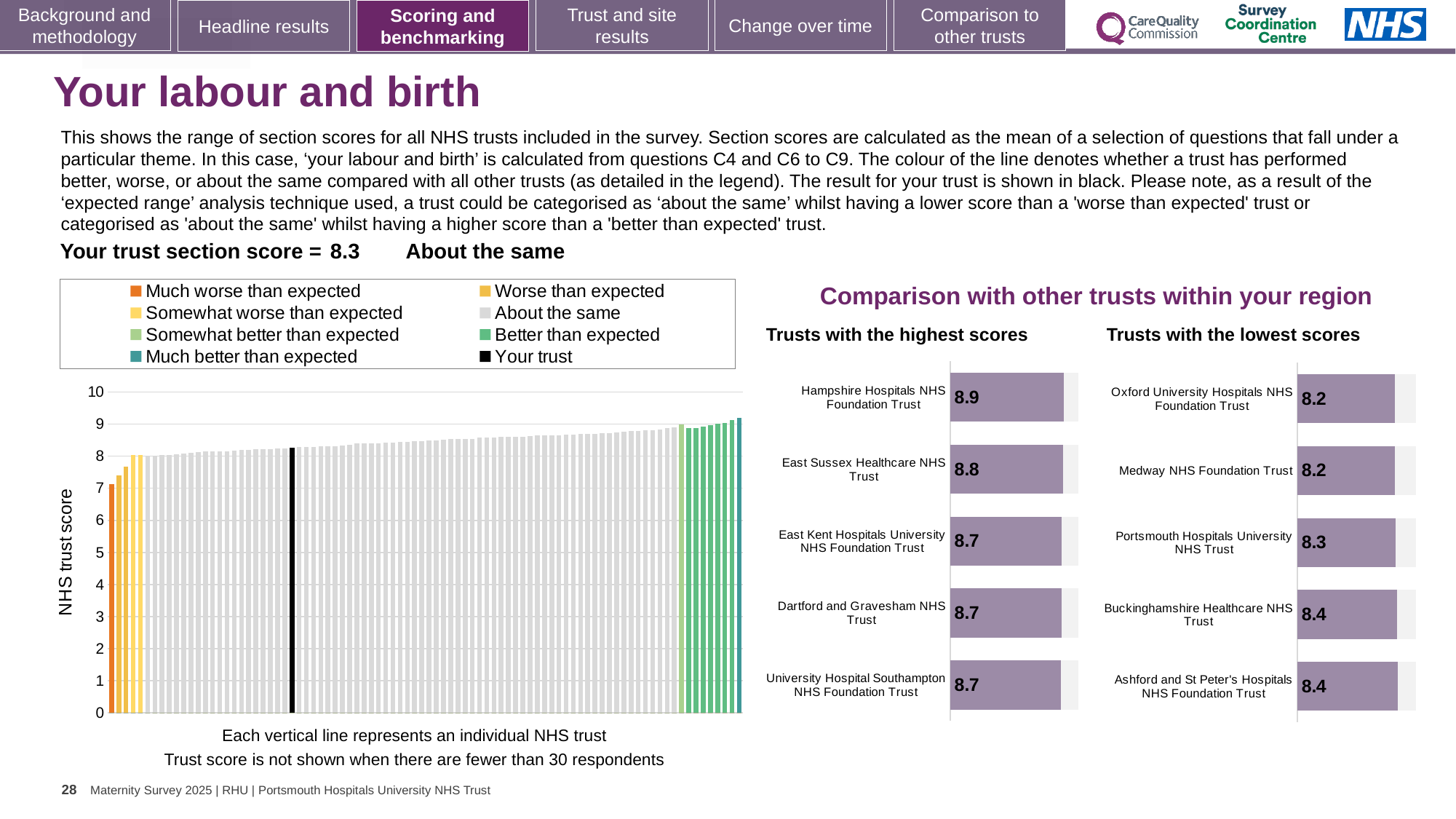
What kind of chart is the large chart on the left showing all NHS trusts? Bar chart In the large chart on the left, do the trust scores rise or fall from left to right along the x axis? Rise In the 'Trusts with the highest scores' chart, which trust has the highest score? Hampshire Hospitals NHS Foundation Trust In the 'Trusts with the lowest scores' chart, which is larger: the score for Buckinghamshire Healthcare NHS Trust or Oxford University Hospitals NHS Foundation Trust? Buckinghamshire Healthcare NHS Trust In the 'Trusts with the lowest scores' chart, what is the difference between the scores of Ashford and St Peter's Hospitals NHS Foundation Trust and Oxford University Hospitals NHS Foundation Trust? 0.2 In the 'Trusts with the lowest scores' chart, how many trusts are shown? 5 In the 'Trusts with the highest scores' chart, what is the difference between the scores of Hampshire Hospitals NHS Foundation Trust and East Sussex Healthcare NHS Trust? 0.1 How many entries does the legend of the large chart on the left list? 8 In the 'Trusts with the highest scores' chart, what is the score for Hampshire Hospitals NHS Foundation Trust? 8.9 In the 'Trusts with the highest scores' chart, how many trusts are shown? 5 In the 'Trusts with the lowest scores' chart, what is the score for Medway NHS Foundation Trust? 8.2 In the 'Trusts with the lowest scores' chart, what is the score for Portsmouth Hospitals University NHS Trust? 8.3